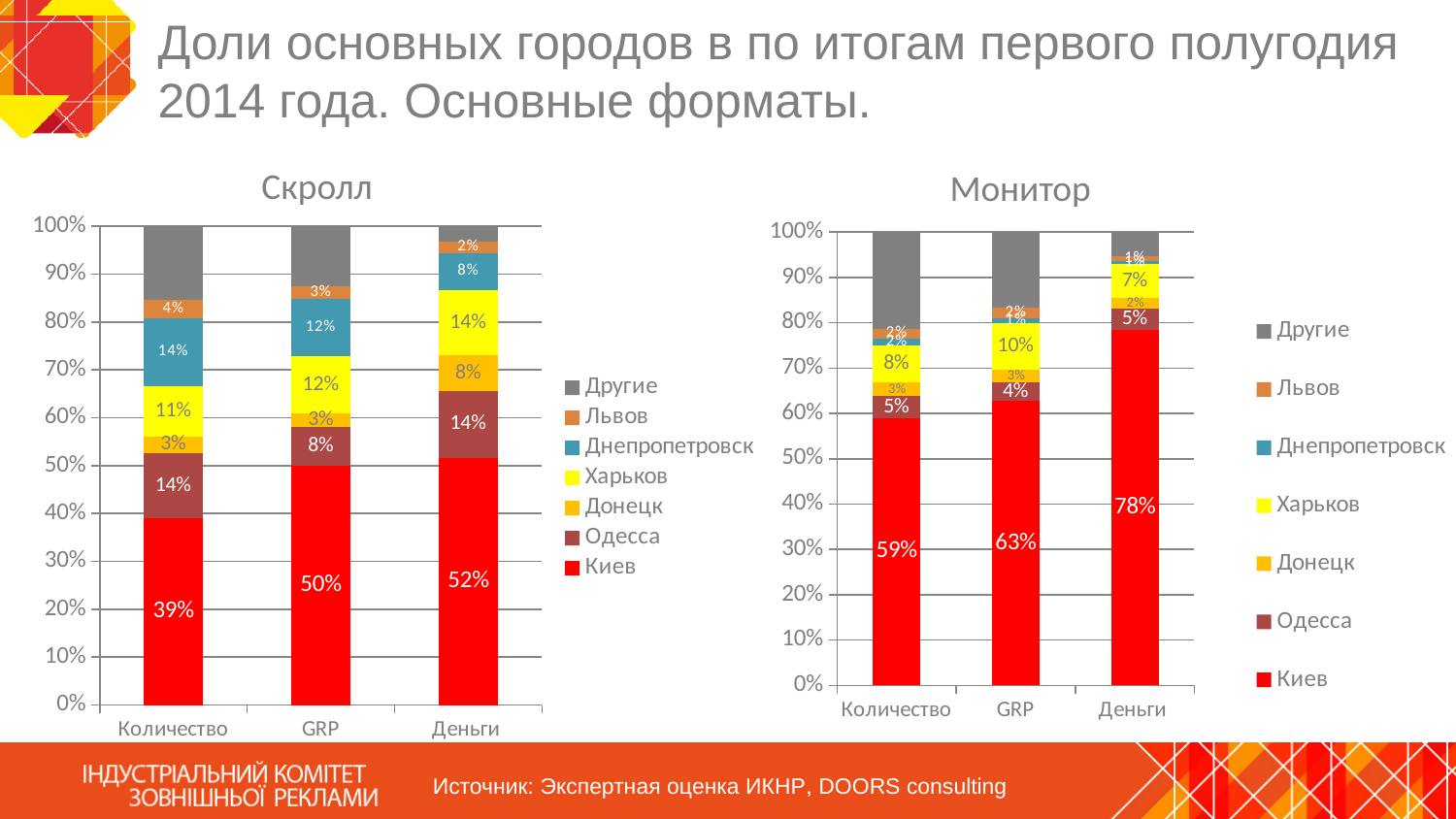
In the Скролл chart, what is the difference between the Киев values for GRP and Количество? 11% In the Скролл chart, which is larger: Одесса in the Деньги bar or Одесса in the GRP bar? Деньги In the Монитор chart, which category has the lowest value for Киев? Количество In the Монитор chart, what is the value for Харьков in the GRP bar? 10% How many categories are shown on the x axis of the Монитор chart? 3 What type of chart is the Монитор chart? Stacked bar chart In the Скролл chart, what is the value for Киев in the Количество bar? 39% How many series does the legend of the Скролл chart list? 7 In the Скролл chart, what is the value for Харьков in the GRP bar? 12% In the Скролл chart, which category has the highest value for Киев? Деньги In the Монитор chart, what is the value for Киев in the Деньги bar? 78% In the Монитор chart, what is the difference between the Киев values for Деньги and GRP? 15%